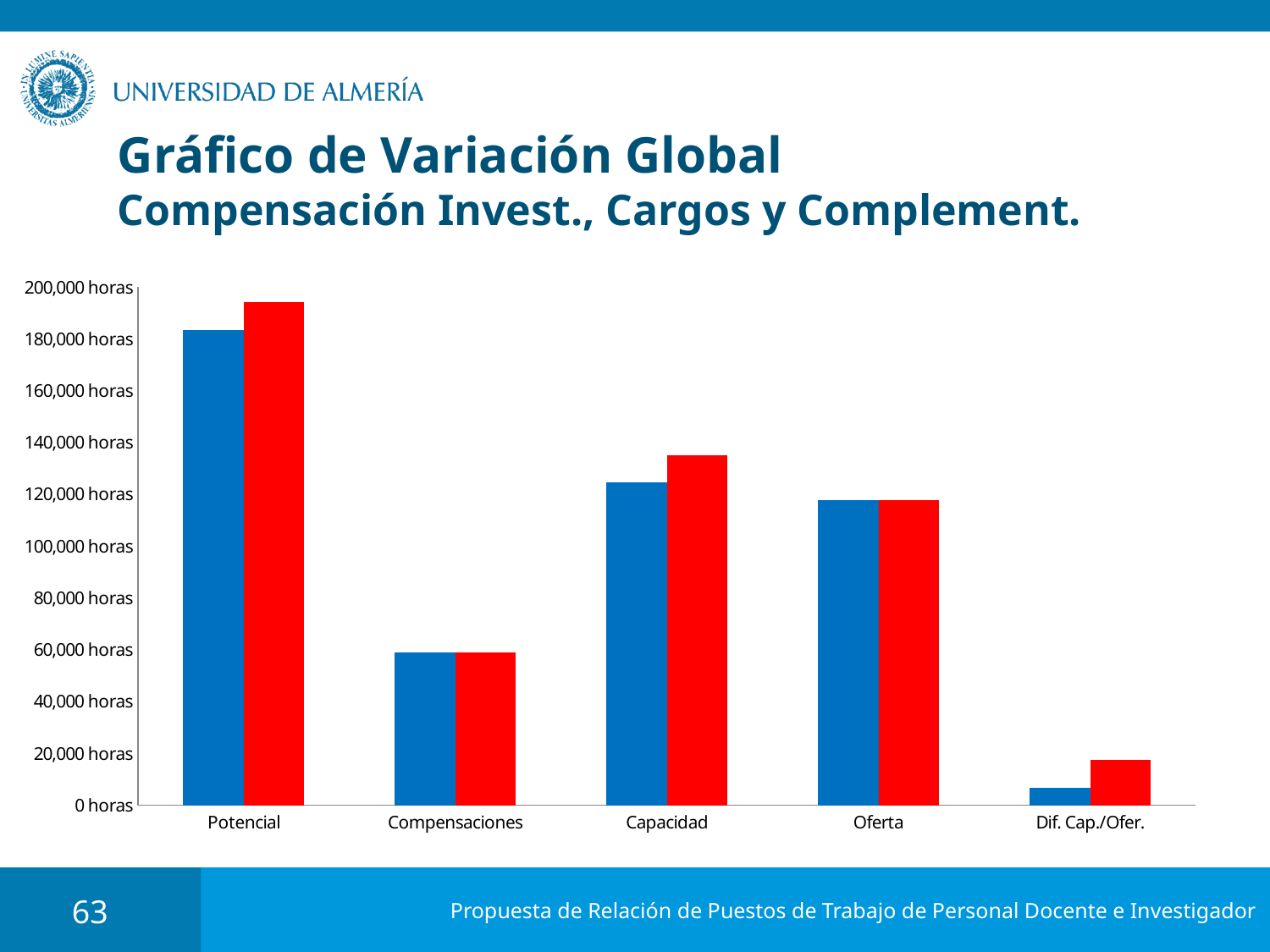
Is the red bar for Potencial greater or less than 180,000 horas? greater Is the red bar for Dif. Cap./Ofer. greater or less than 20,000 horas? less Which category has the larger blue bar, Potencial or Capacidad? Potencial Which category has the larger red bar, Capacidad or Oferta? Capacidad Which category has the highest bars in the chart? Potencial Which category has the lowest bars in the chart? Dif. Cap./Ofer. Is the blue bar for Compensaciones greater or less than 80,000 horas? less What unit is shown on the vertical axis of the chart? horas What kind of chart is shown on the slide? bar chart How many categories are shown on the x axis of the chart? 5 How many bars are plotted for each category in the chart? 2